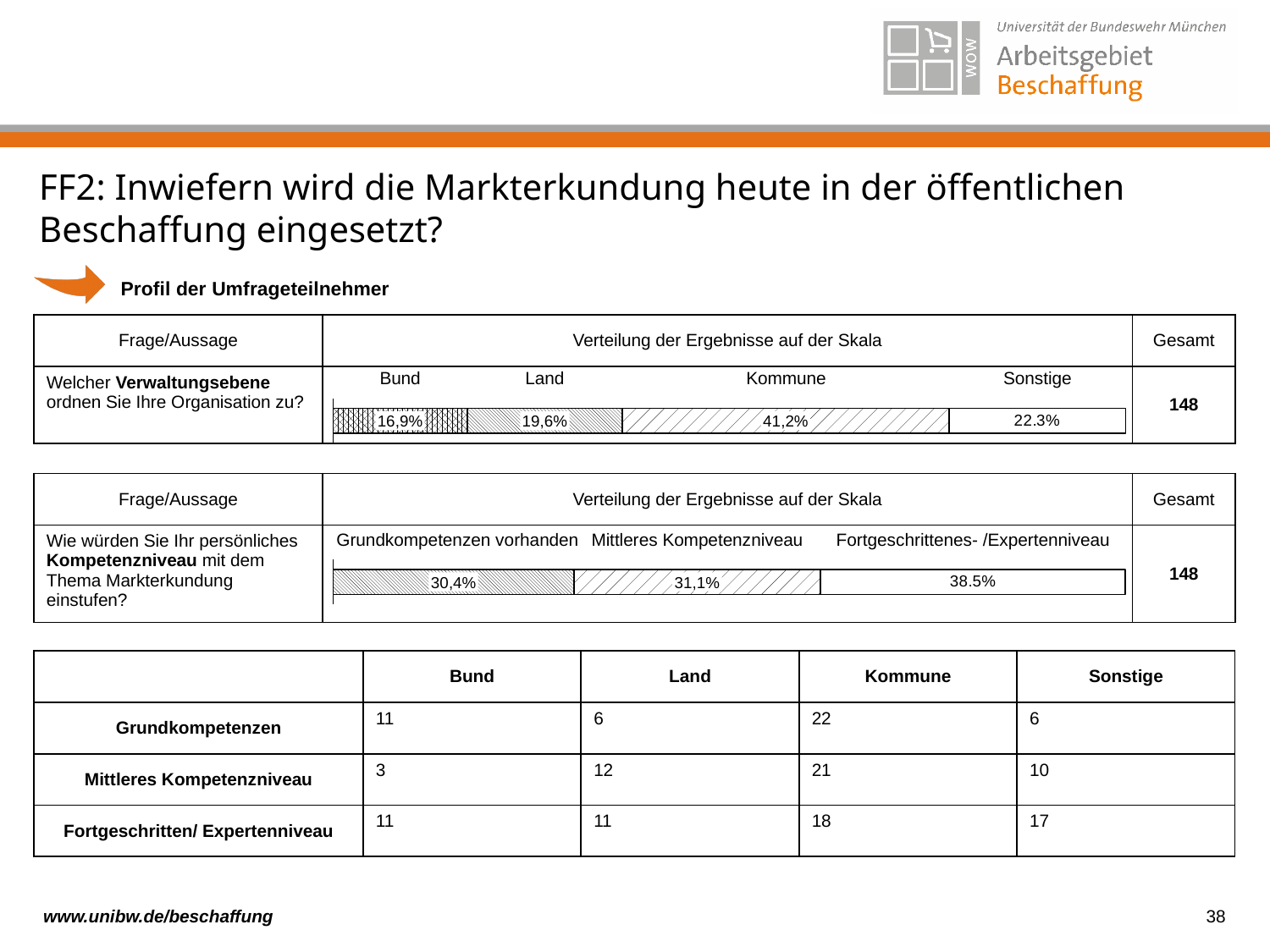
In the upper chart (Verwaltungsebene), what percentage is shown for Bund? 16,9% In the lower chart (Kompetenzniveau), which category has the largest share? Fortgeschrittenes- /Expertenniveau In the upper chart (Verwaltungsebene), which category has the largest share? Kommune In the upper chart (Verwaltungsebene), what percentage is shown for Sonstige? 22.3% In the upper chart (Verwaltungsebene), which is larger: the share for Land or the share for Sonstige? Sonstige What kind of chart is used to show the Verwaltungsebene distribution in the upper chart? Stacked horizontal bar chart In the lower chart (Kompetenzniveau), what percentage is shown for Grundkompetenzen vorhanden? 30,4% In the upper chart (Verwaltungsebene), how many categories are shown in the bar? 4 In the upper chart (Verwaltungsebene), what percentage is shown for Kommune? 41,2% In the lower chart (Kompetenzniveau), what percentage is shown for Fortgeschrittenes- /Expertenniveau? 38.5% In the upper chart (Verwaltungsebene), which category has the smallest share? Bund In the lower chart (Kompetenzniveau), how many categories are shown in the bar? 3